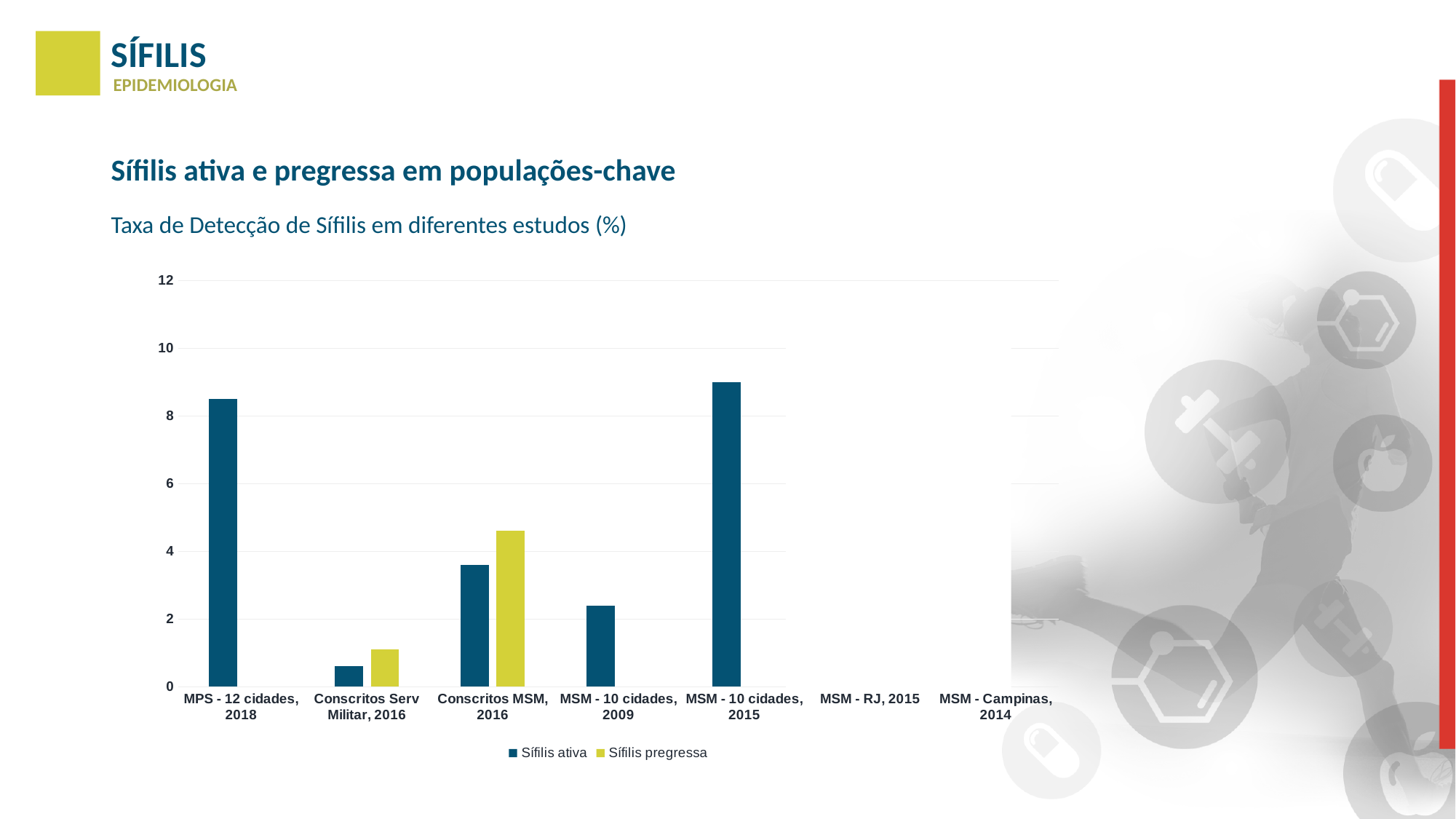
How many categories are shown on the x axis? 7 What kind of chart is shown on the slide? bar chart How many series does the legend list? 2 Is the Sífilis pregressa value for Conscritos MSM, 2016 greater or less than 4? greater What is the subtitle of the chart? Taxa de Detecção de Sífilis em diferentes estudos (%) Which category has the highest value for Sífilis ativa? MSM - 10 cidades, 2015 For Conscritos MSM, 2016, which is larger: Sífilis ativa or Sífilis pregressa? Sífilis pregressa Is the Sífilis ativa value for MPS - 12 cidades, 2018 greater or less than 8? greater Which is larger: the Sífilis ativa value for MSM - 10 cidades, 2009 or for MSM - 10 cidades, 2015? MSM - 10 cidades, 2015 Is the Sífilis ativa value for Conscritos Serv Militar, 2016 greater or less than 2? less Among the categories with a visible Sífilis ativa bar, which has the lowest value? Conscritos Serv Militar, 2016